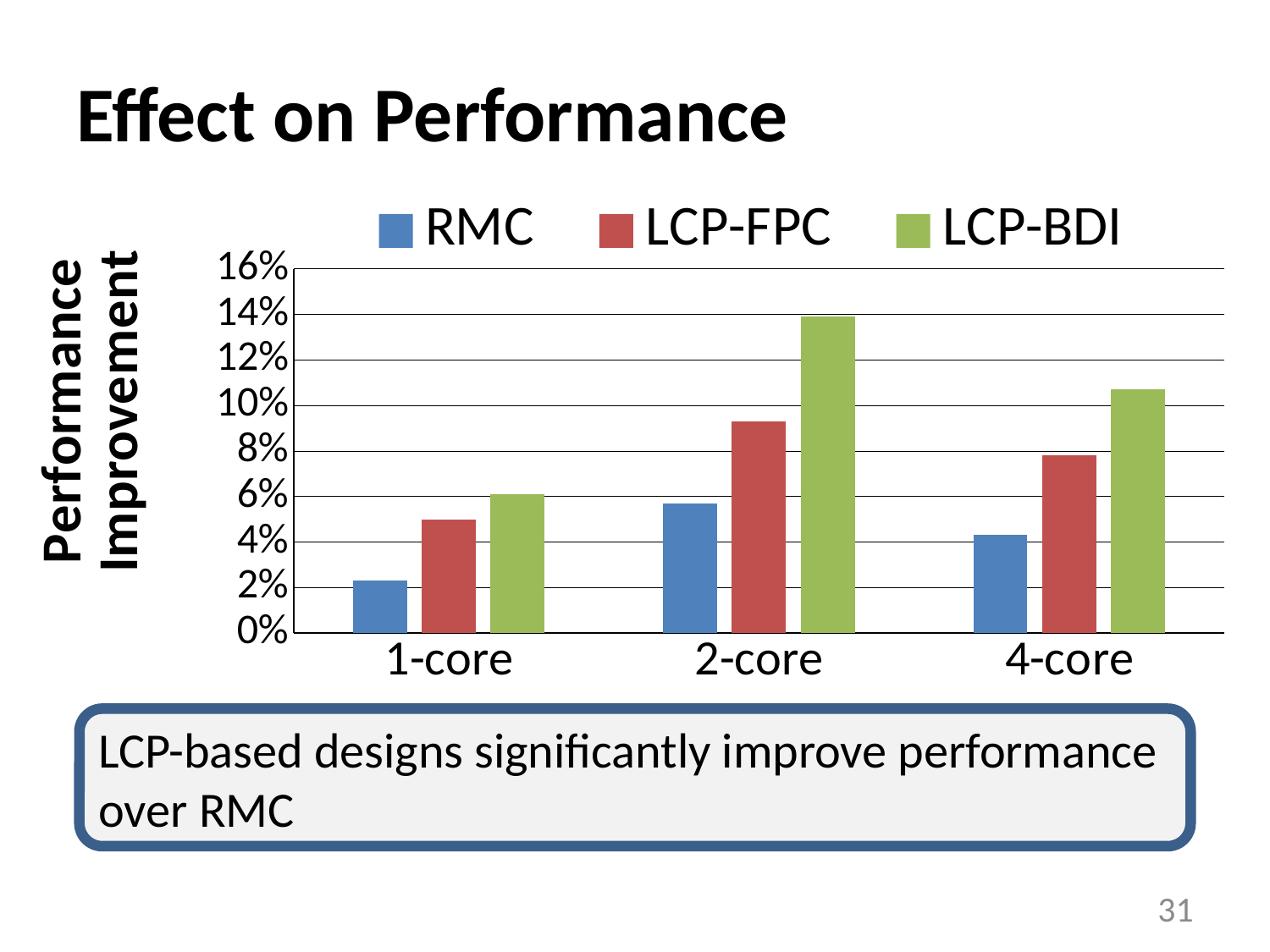
Is the LCP-BDI value for 4-core greater or less than 8%? greater Which is larger, the LCP-BDI value for 2-core or the LCP-BDI value for 4-core? 2-core Is the RMC value for 1-core greater or less than 4%? less Which series and category has the tallest bar in the chart? LCP-BDI at 2-core Which series and category has the shortest bar in the chart? RMC at 1-core Is the LCP-BDI value for 2-core greater or less than 12%? greater How many core-count categories are shown on the x axis? 3 For which core count is the LCP-FPC value highest? 2-core What is the label on the y axis? Performance Improvement What kind of chart is shown on the slide? bar chart How many series does the legend list? 3